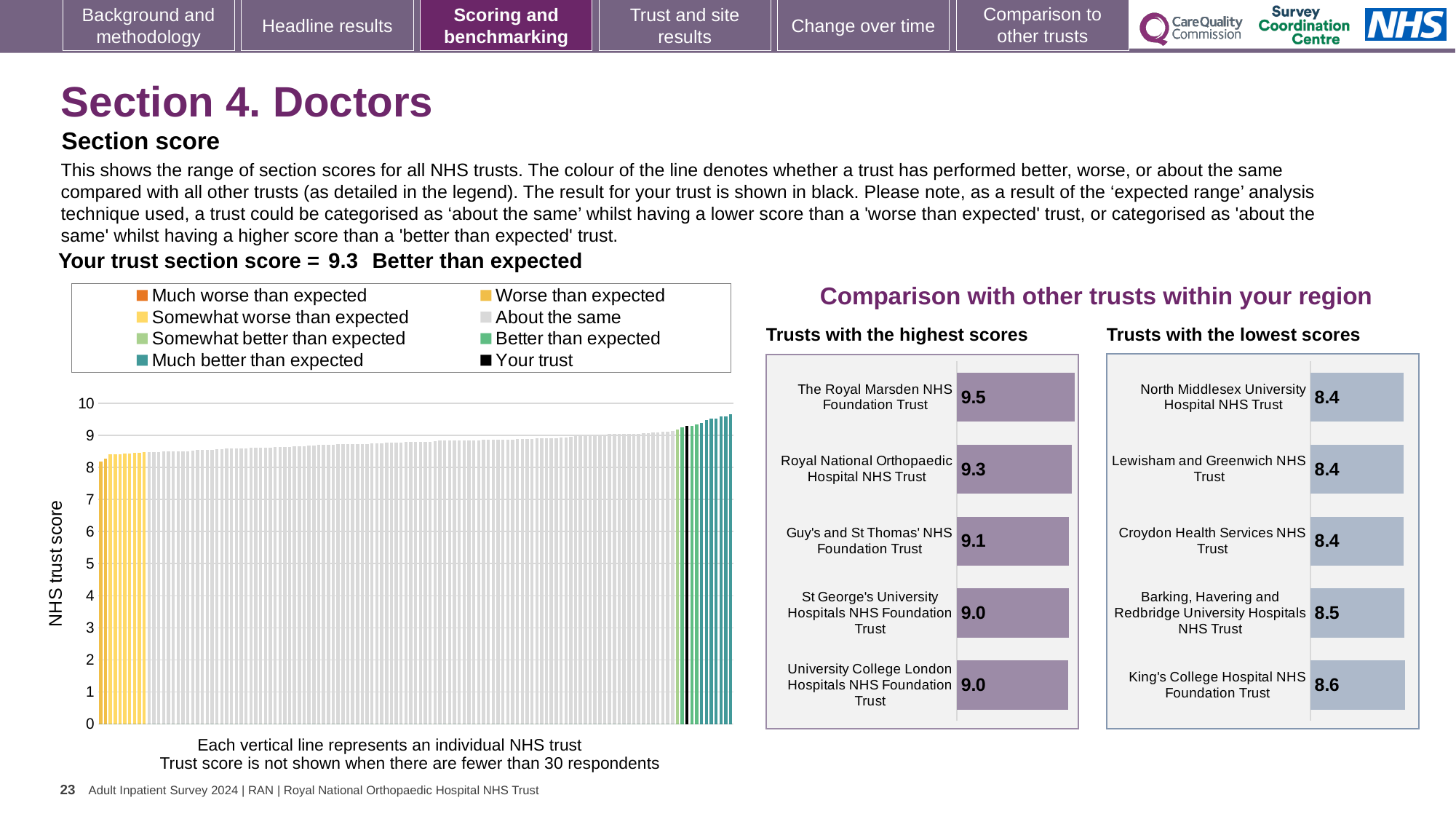
How many entries does the legend of the large chart on the left list? 8 In the 'Trusts with the highest scores' chart, what is the score for Guy's and St Thomas' NHS Foundation Trust? 9.1 How many trusts are shown in the 'Trusts with the highest scores' chart? 5 In the 'Trusts with the highest scores' chart, what is the score for The Royal Marsden NHS Foundation Trust? 9.5 In the 'Trusts with the highest scores' chart, which trust has the highest score? The Royal Marsden NHS Foundation Trust What kind of chart is the large chart on the left showing the range of section scores for all NHS trusts? Bar chart In the large chart on the left, do the trust scores rise or fall from left to right along the x axis? Rise In the 'Trusts with the lowest scores' chart, what is the score for Barking, Havering and Redbridge University Hospitals NHS Trust? 8.5 In the 'Trusts with the lowest scores' chart, what is the score for King's College Hospital NHS Foundation Trust? 8.6 In the 'Trusts with the lowest scores' chart, which trust has the highest score? King's College Hospital NHS Foundation Trust In the 'Trusts with the lowest scores' chart, what is the difference between the scores of King's College Hospital NHS Foundation Trust and Croydon Health Services NHS Trust? 0.2 In the 'Trusts with the highest scores' chart, what is the difference between the scores of The Royal Marsden NHS Foundation Trust and Guy's and St Thomas' NHS Foundation Trust? 0.4